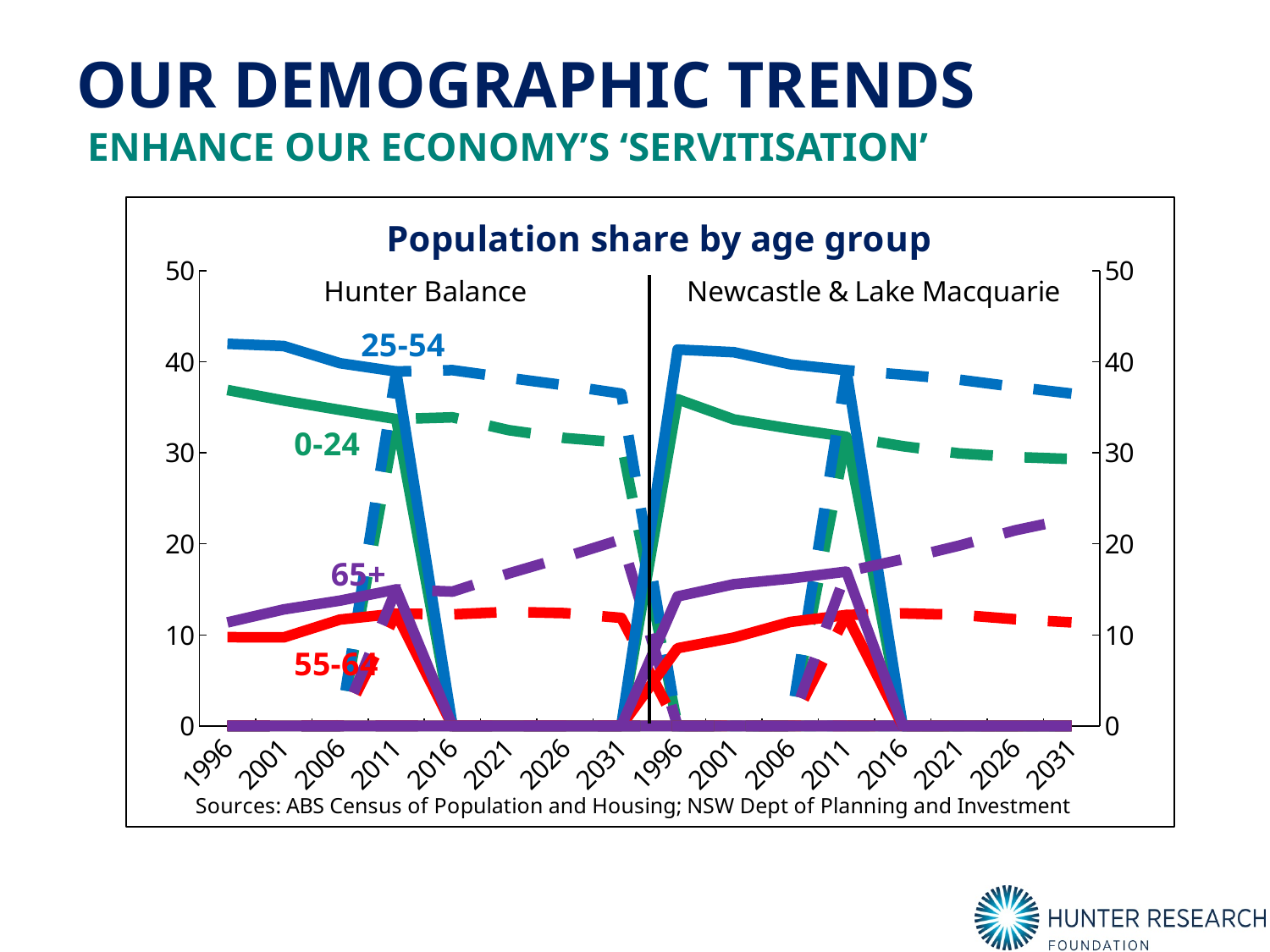
What is the title of the chart? Population share by age group In the Newcastle & Lake Macquarie panel, is the 0-24 share in 1996 greater or less than 30? greater In the Newcastle & Lake Macquarie panel, does the 0-24 share rise or fall from 1996 to 2031? fall In the Hunter Balance panel, which age group has the highest population share in 1996? 25-54 In the Hunter Balance panel, which age group has the lowest population share in 1996? 55-64 In the Hunter Balance panel, does the 65+ share rise or fall from 1996 to 2031? rise How many age groups are labelled on the chart? 4 What kind of chart is shown on the slide? line chart In the Newcastle & Lake Macquarie panel, which is larger in 2031: the 25-54 share or the 0-24 share? 25-54 How many years are marked on the x axis of the Hunter Balance panel? 8 In the Hunter Balance panel, is the 25-54 share in 1996 greater or less than 40? greater